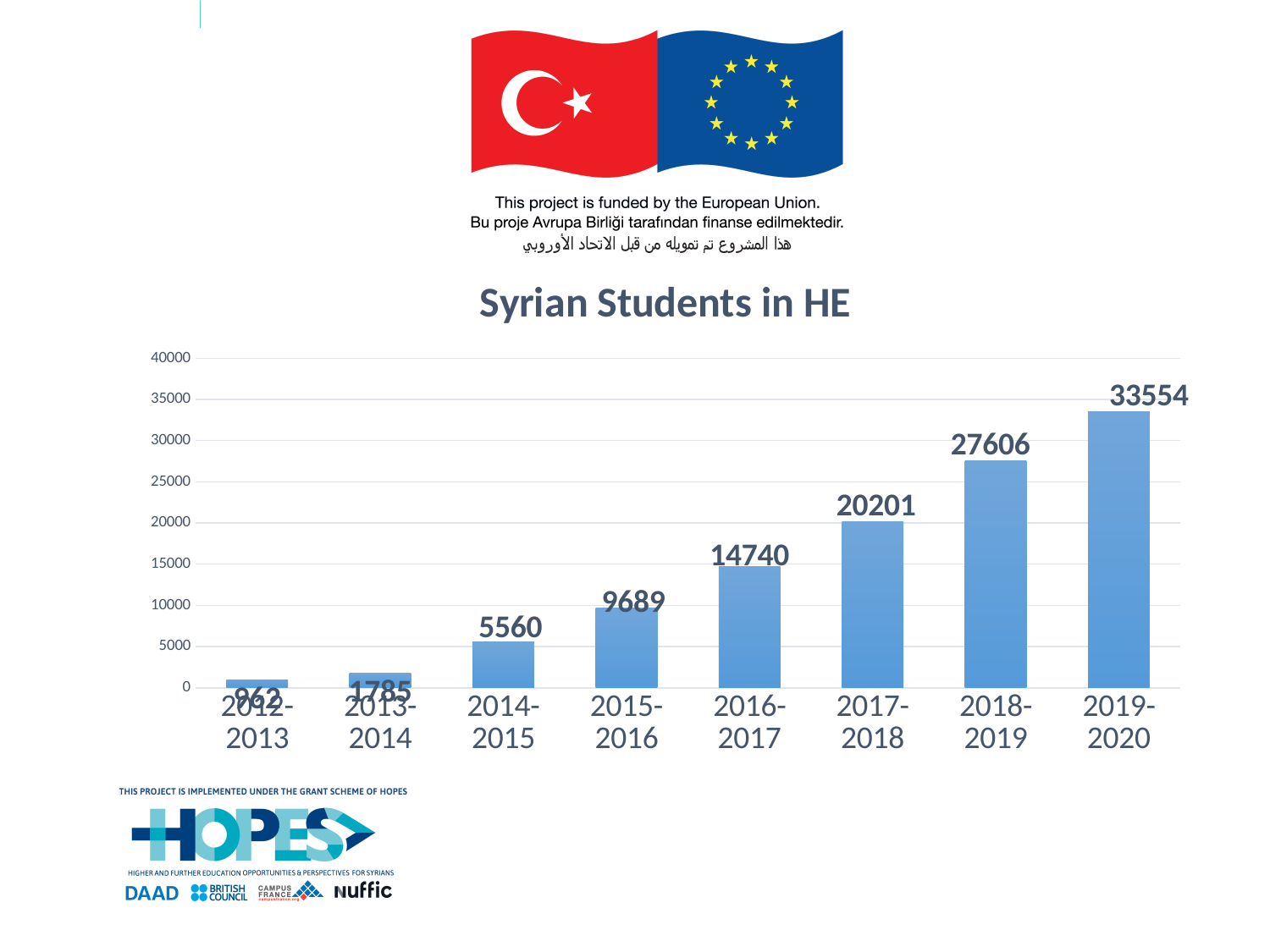
Which academic year has the lowest value? 2012-2013 What type of chart is shown on the slide? bar chart What is the value for 2014-2015? 5560 Which academic year has the highest value? 2019-2020 What is the value for 2016-2017? 14740 Do the values rise or fall from 2012-2013 to 2019-2020? rise What is the title of the chart? Syrian Students in HE Which is larger, the value for 2017-2018 or the value for 2015-2016? 2017-2018 What is the difference between the values for 2019-2020 and 2018-2019? 5948 Is the value for 2018-2019 greater or less than 25000? greater What is the value for 2019-2020? 33554 How many academic years are shown on the x axis of the chart? 8